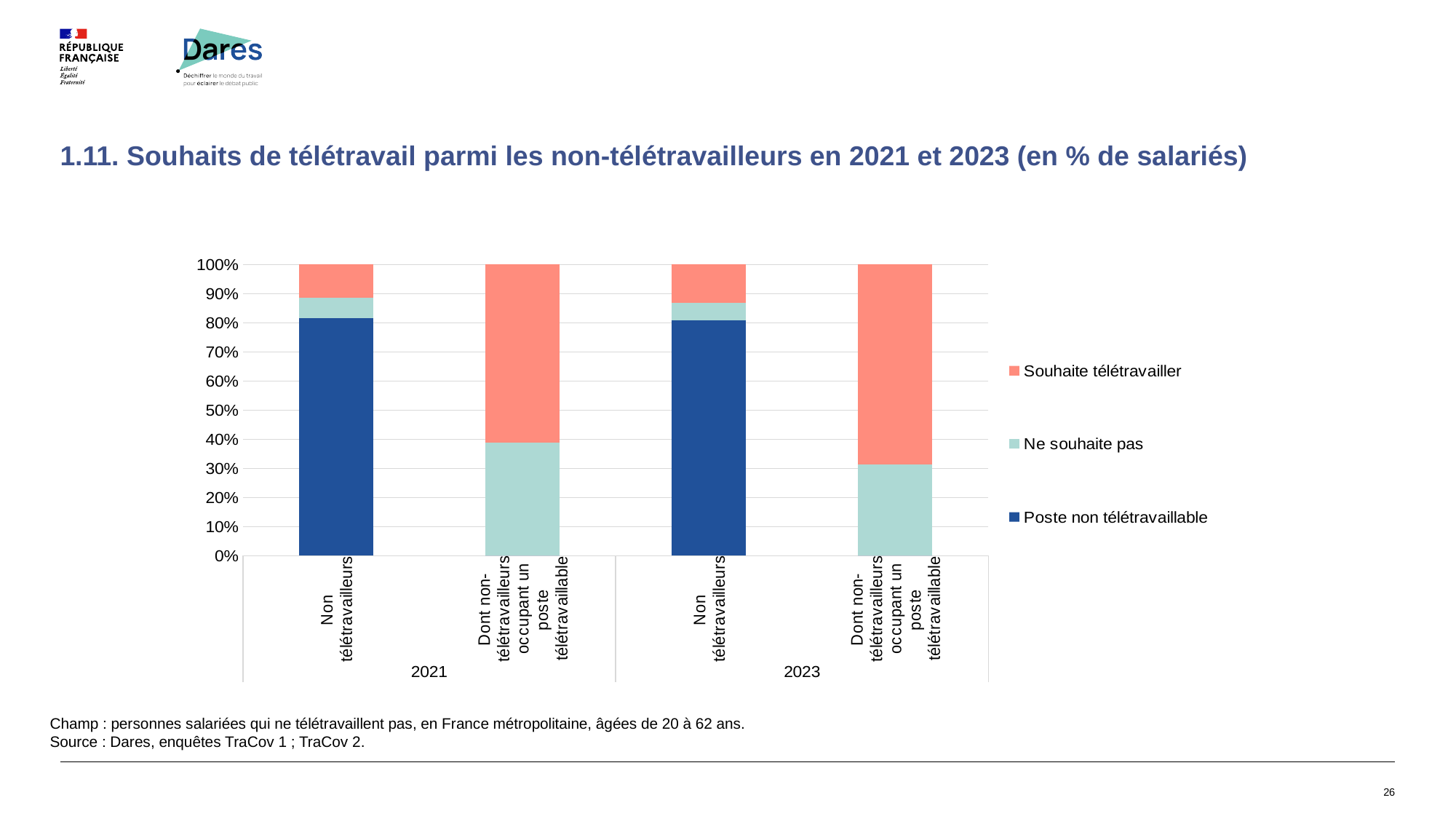
In 2021, is the 'Ne souhaite pas' share for 'Dont non-télétravailleurs occupant un poste télétravaillable' greater or less than 50%? less How many bars are plotted in the chart? 4 In 2021, is the 'Poste non télétravaillable' share for 'Non télétravailleurs' greater or less than 70%? greater In 2023, is the 'Souhaite télétravailler' share for 'Dont non-télétravailleurs occupant un poste télétravaillable' greater or less than 60%? greater For 'Dont non-télétravailleurs occupant un poste télétravaillable', does the 'Souhaite télétravailler' share rise or fall from 2021 to 2023? rise How many series does the legend list? 3 For 'Dont non-télétravailleurs occupant un poste télétravaillable', is the 'Ne souhaite pas' share larger in 2021 or in 2023? 2021 Which two years are compared on the x axis? 2021 and 2023 Which series is shown in dark blue in the legend? Poste non télétravaillable What kind of chart is shown on the slide? Stacked bar chart What is the total height of each stacked bar? 100%